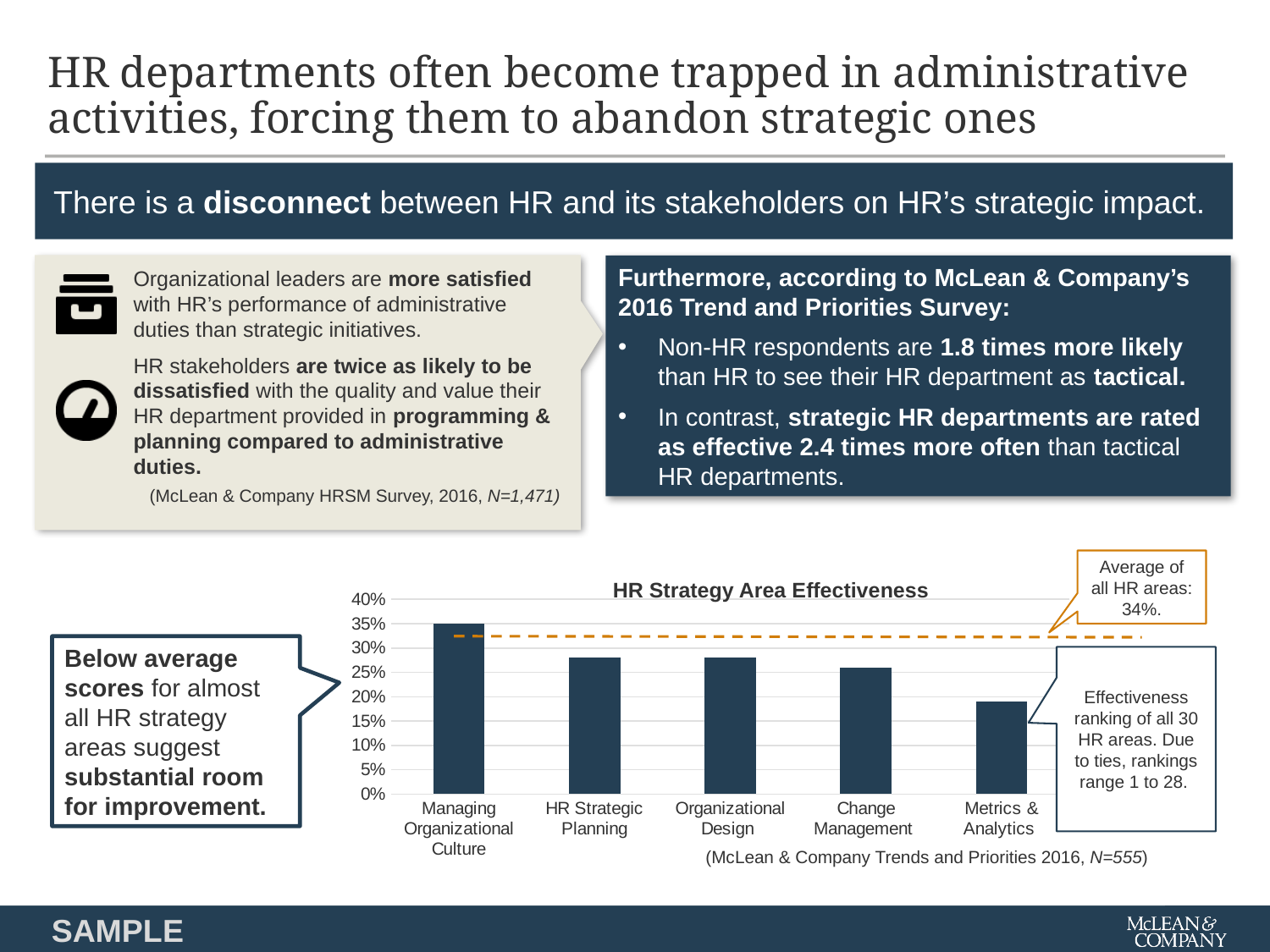
Which HR strategy area has the highest effectiveness in the chart? Managing Organizational Culture What is the title of the bar chart on the slide? HR Strategy Area Effectiveness How many HR strategy areas are shown in the HR Strategy Area Effectiveness chart? 5 Is the value for Change Management greater or less than 30%? less Is the value for HR Strategic Planning greater or less than 20%? greater Is the value for Managing Organizational Culture greater or less than 30%? greater Which is larger, the value for Change Management or the value for Metrics & Analytics? Change Management What type of chart is the HR Strategy Area Effectiveness chart? bar chart According to the callout on the chart, what is the average effectiveness of all HR areas? 34% Which HR strategy area has the lowest effectiveness in the chart? Metrics & Analytics Which is larger, the value for Managing Organizational Culture or the value for Organizational Design? Managing Organizational Culture